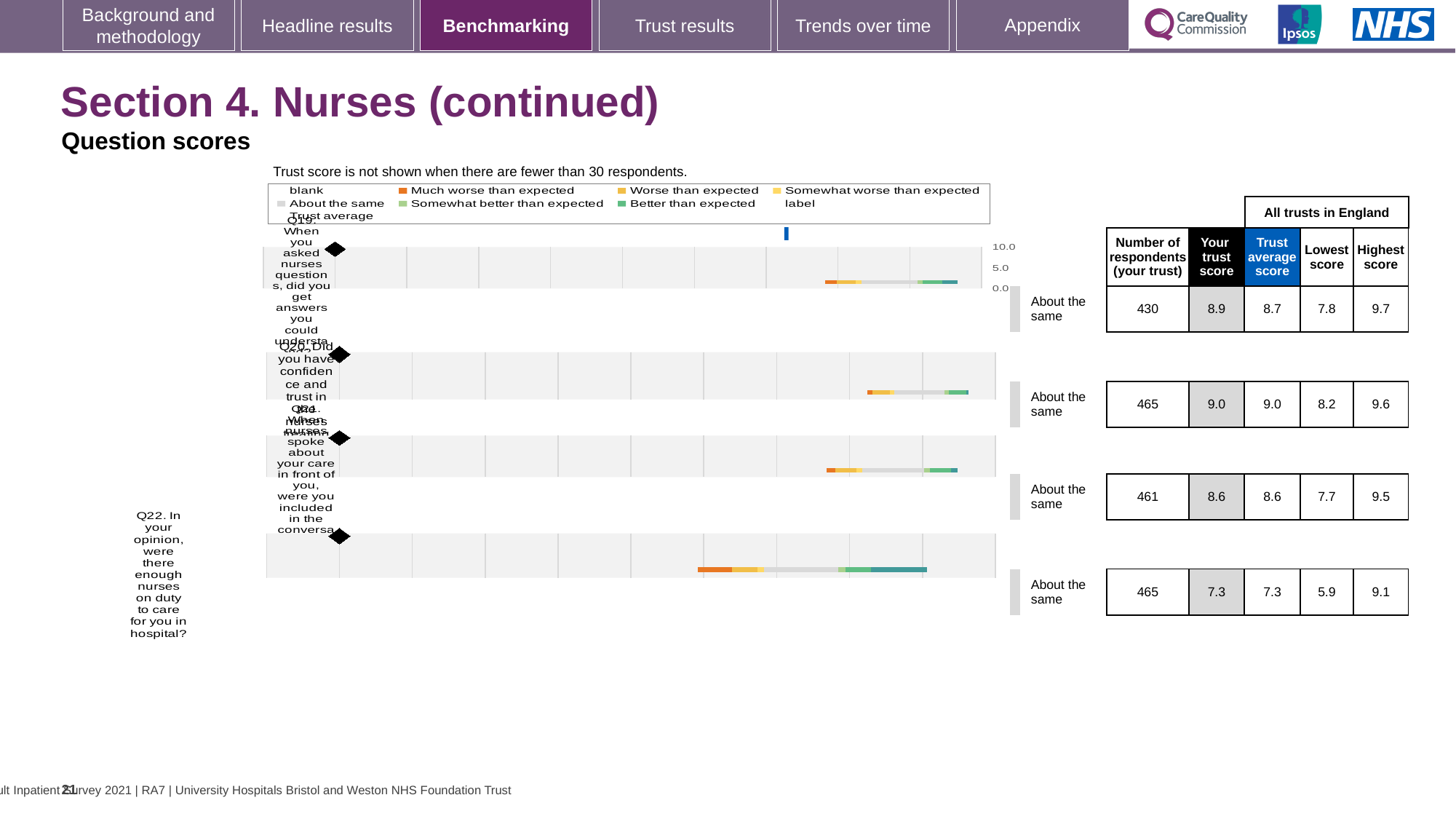
What is the difference between the highest score (9.7) and the lowest score (7.8) for Q19? 1.9 Which question has the lowest 'Your trust score' in the table? Q22 In the table next to the chart, what is the 'Your trust score' for Q22? 7.3 What is the difference between the highest score (9.1) and the lowest score (5.9) for Q22? 3.2 How many questions (categories) are plotted in the chart? 4 What benchmark category label is shown beside the chart for Q22? About the same What kind of chart is used to show the question scores on this slide? bar chart For Q19, which is larger: your trust score or the trust average score? Your trust score In the table next to the chart, how many respondents answered Q19 for your trust? 430 Which question has the highest 'Your trust score' in the table? Q20 In the table next to the chart, what is the lowest score across all trusts in England for Q22? 5.9